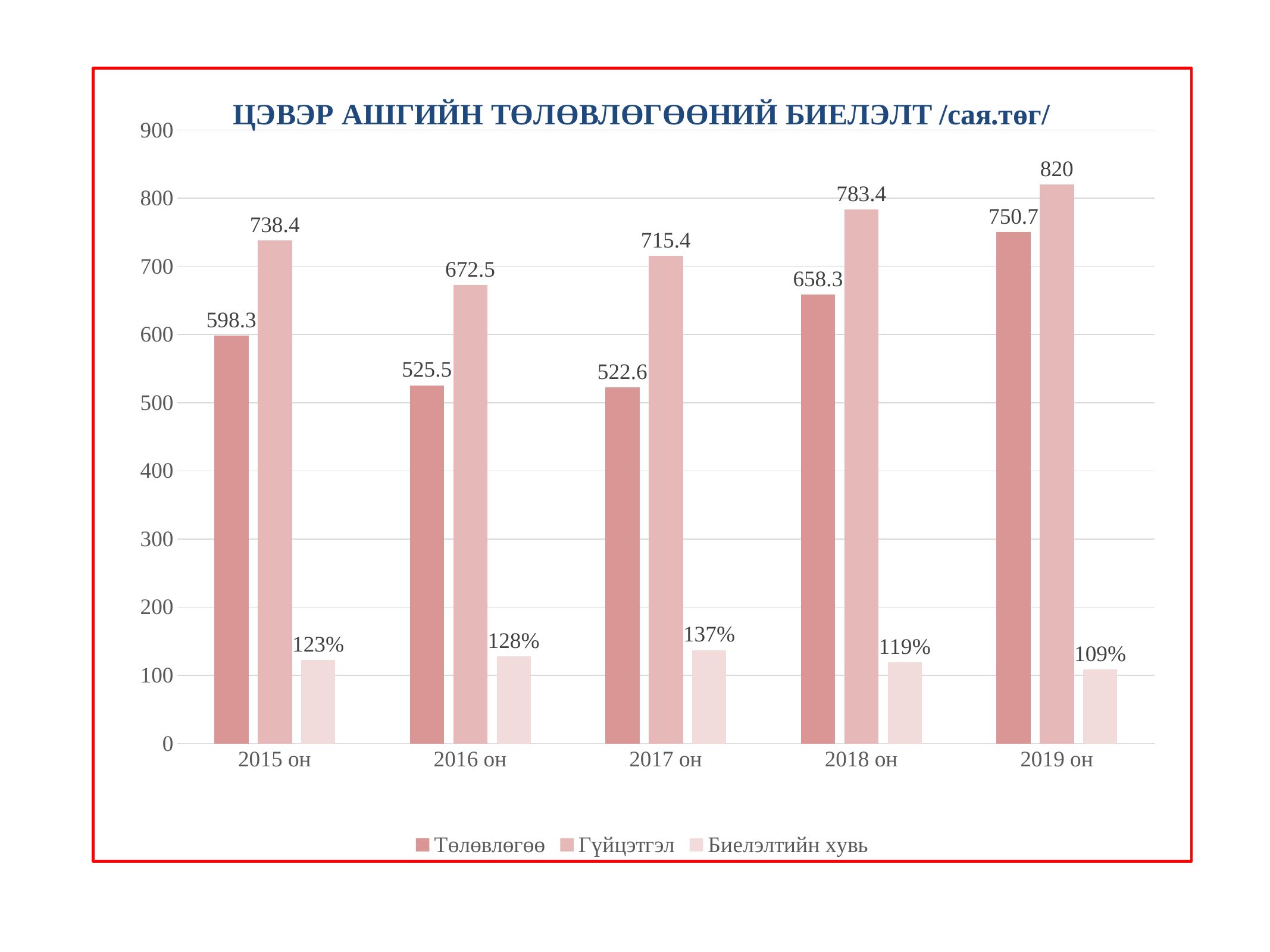
What is the Гүйцэтгэл value for 2017 он? 715.4 Which is larger for 2019 он: the Төлөвлөгөө value or the Гүйцэтгэл value? Гүйцэтгэл What is the Төлөвлөгөө value for 2018 он? 658.3 In which year is the Биелэлтийн хувь value highest? 2017 он What is the difference between the Гүйцэтгэл and Төлөвлөгөө values for 2015 он? 140.1 What is the title of the chart? ЦЭВЭР АШГИЙН ТӨЛӨВЛӨГӨӨНИЙ БИЕЛЭЛТ /сая.төг/ How many series does the legend list? 3 What kind of chart is shown on the slide? Bar chart What is the Биелэлтийн хувь value for 2016 он? 128% How many years are shown on the x axis? 5 In which year is the Гүйцэтгэл value highest? 2019 он In which year is the Төлөвлөгөө value lowest? 2017 он